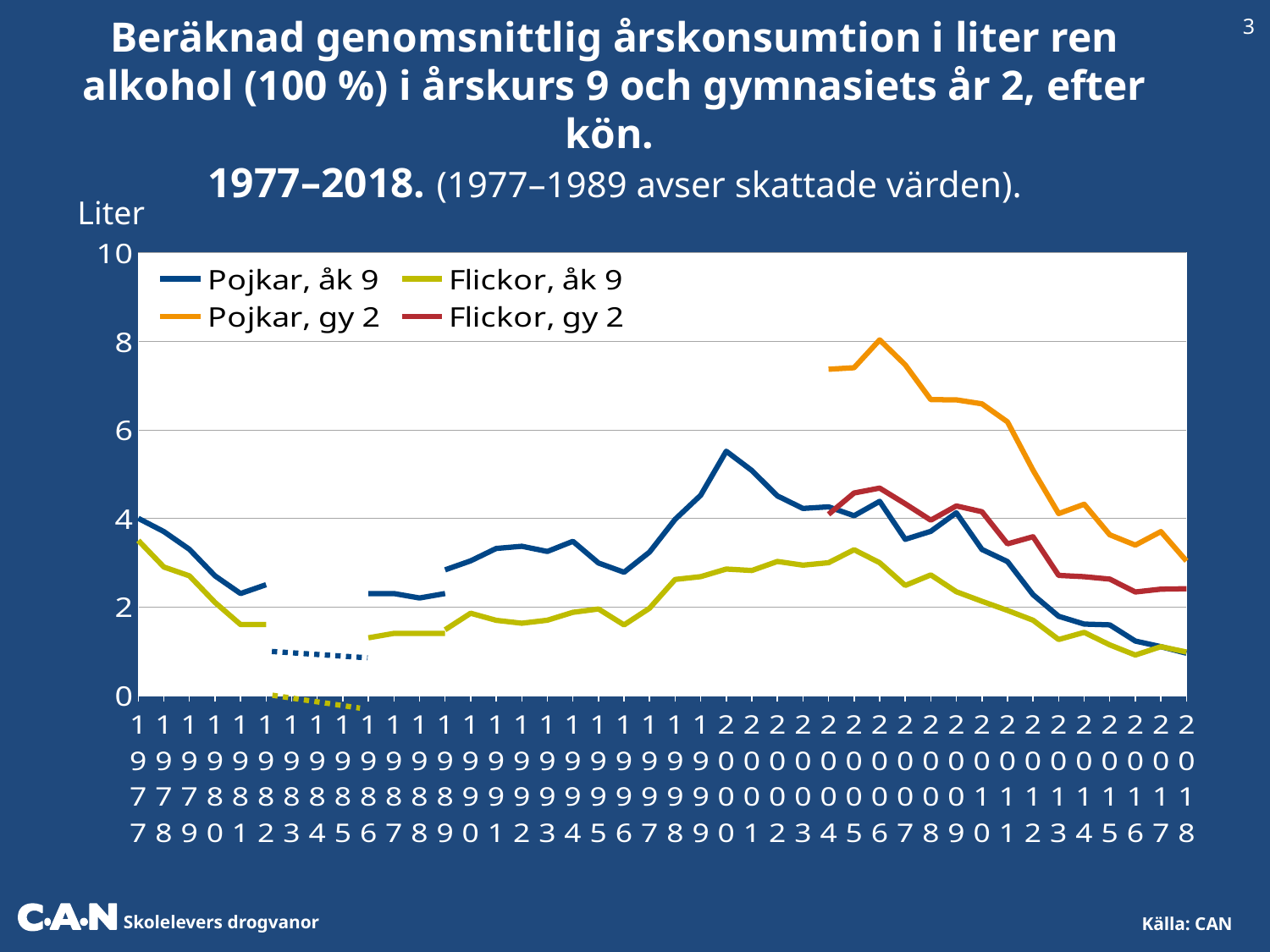
What is the label on the vertical axis? Liter What are the four series named in the legend? Pojkar, åk 9; Flickor, åk 9; Pojkar, gy 2; Flickor, gy 2 What kind of chart is shown on the slide? line chart Is the value for Pojkar, gy 2 in 2005 greater or less than 6? greater Is the value for Pojkar, åk 9 in 2000 greater or less than 4? greater Is the value for Flickor, åk 9 in 1977 greater or less than 2? greater How many years does the x axis cover, from 1977 to 2018 inclusive? 42 Does the Pojkar, gy 2 series rise or fall from 2005 to 2018? fall In 2005, which is larger: Pojkar, gy 2 or Flickor, gy 2? Pojkar, gy 2 How many series does the legend list? 4 Which series reaches the highest value anywhere on the chart? Pojkar, gy 2